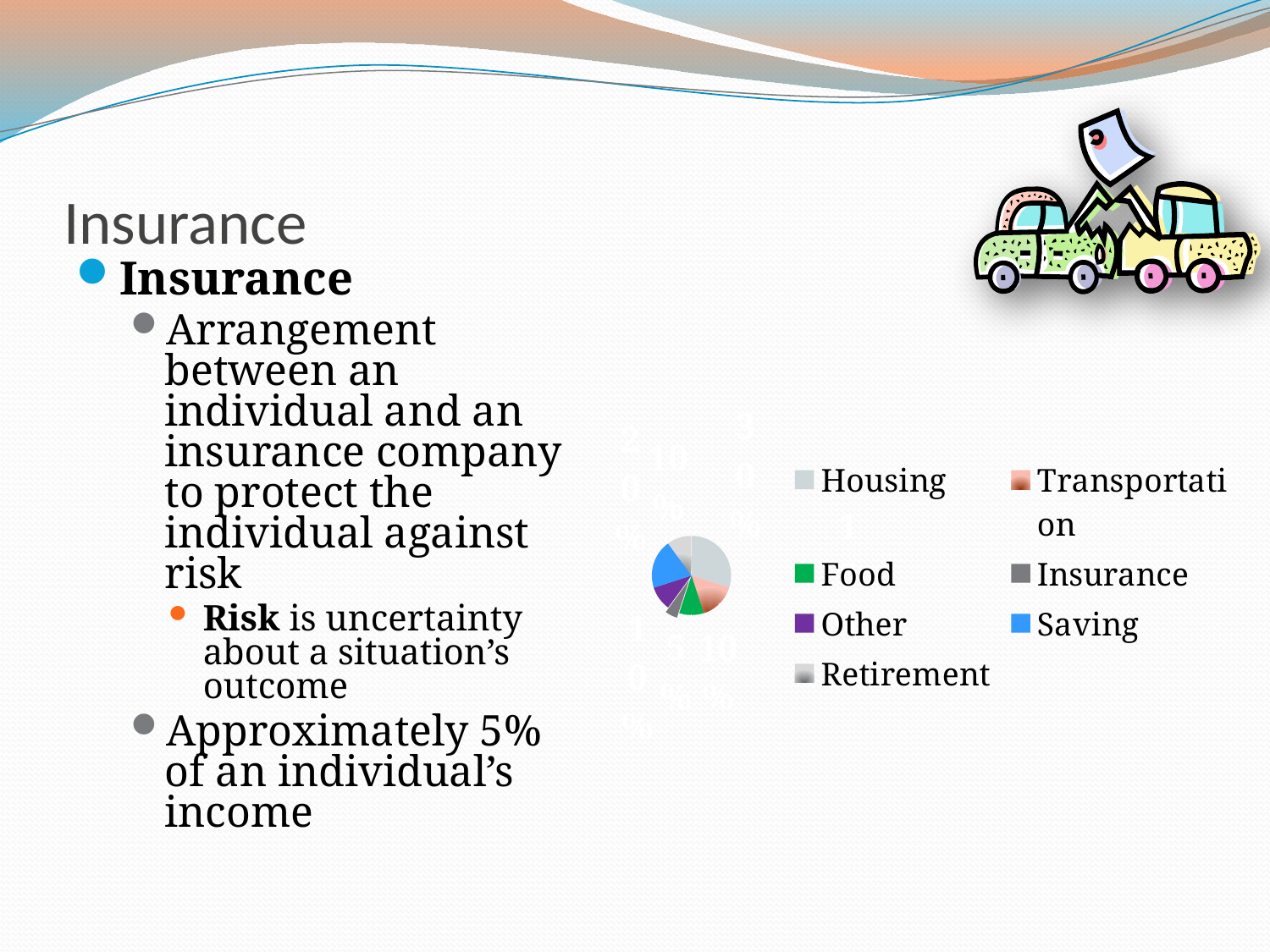
Is the slice for Saving larger or smaller than the slice for Insurance? larger Which category in the pie chart is shown in green? Food Which category has the largest slice in the pie chart? Housing Which category in the pie chart is shown in blue? Saving What kind of chart is shown on the slide? pie chart How many categories does the pie chart's legend list? 7 Is the slice for Housing larger or smaller than the slice for Food? larger